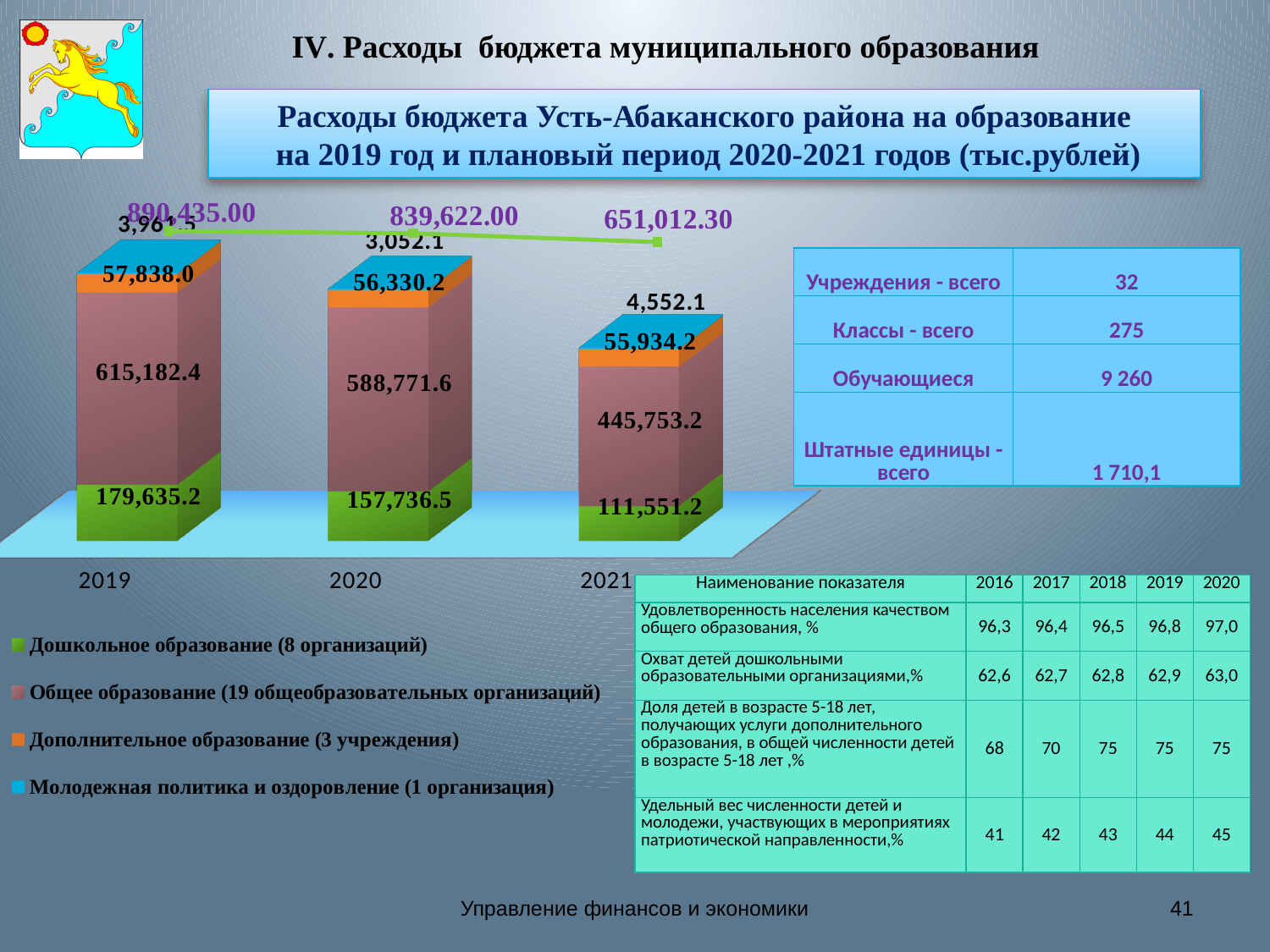
What is the value for Дополнительное образование in 2020? 56,330.2 What is the difference between the Дошкольное образование values for 2019 and 2021? 68,084.0 What type of chart is used to show the education budget expenditures by year? stacked bar chart How many series does the chart legend list? 4 What value is printed on the line above the 2020 bar? 839,622.00 How many years (categories) are shown on the x axis of the chart? 3 What is the value for Дошкольное образование in 2021? 111,551.2 What is the value for Молодежная политика и оздоровление in 2021? 4,552.1 In which year is the value for Дошкольное образование the lowest? 2021 In which year is the value for Общее образование the highest? 2019 Does the value for Общее образование rise or fall from 2019 to 2021? fall What is the value for Общее образование in 2019? 615,182.4